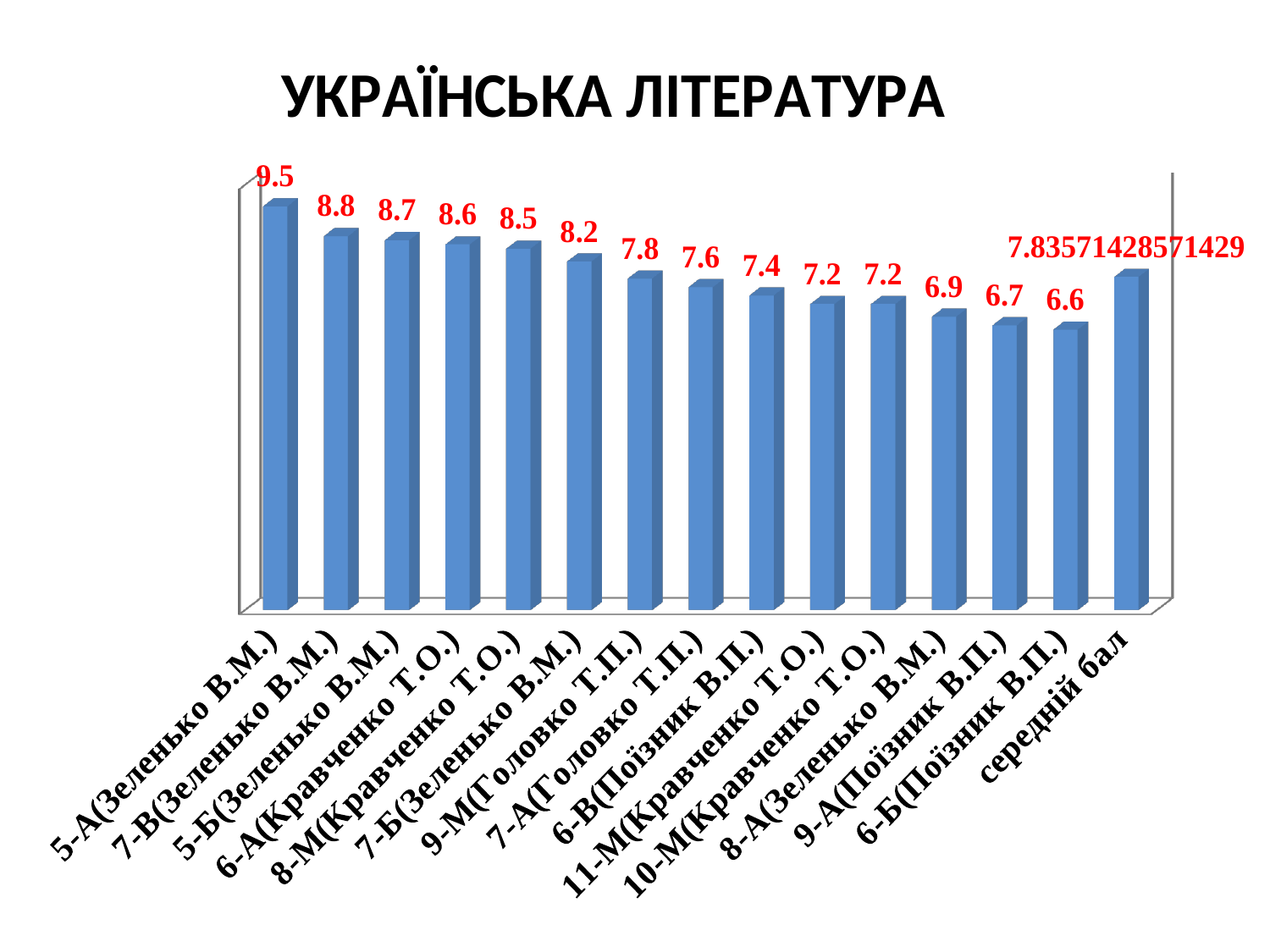
Which class has the highest value on the chart? 5-А(Зеленько В.М.) How many bars are plotted on the chart? 15 Which has a larger value, 6-А(Кравченко Т.О.) or 6-В(Поїзник В.П.)? 6-А(Кравченко Т.О.) What is the difference between the values for 7-В(Зеленько В.М.) and 7-Б(Зеленько В.М.)? 0.6 What value is labelled on the середній бал bar? 7.83571428571429 What is the difference between the values for 5-А(Зеленько В.М.) and 6-Б(Поїзник В.П.)? 2.9 What is the value shown for 5-А(Зеленько В.М.)? 9.5 What is the title of the chart? УКРАЇНСЬКА ЛІТЕРАТУРА What type of chart is shown on the slide? Bar chart What is the value shown for 9-М(Головко Т.П.)? 7.8 What is the value shown for 6-Б(Поїзник В.П.)? 6.6 Which class has the lowest value on the chart? 6-Б(Поїзник В.П.)